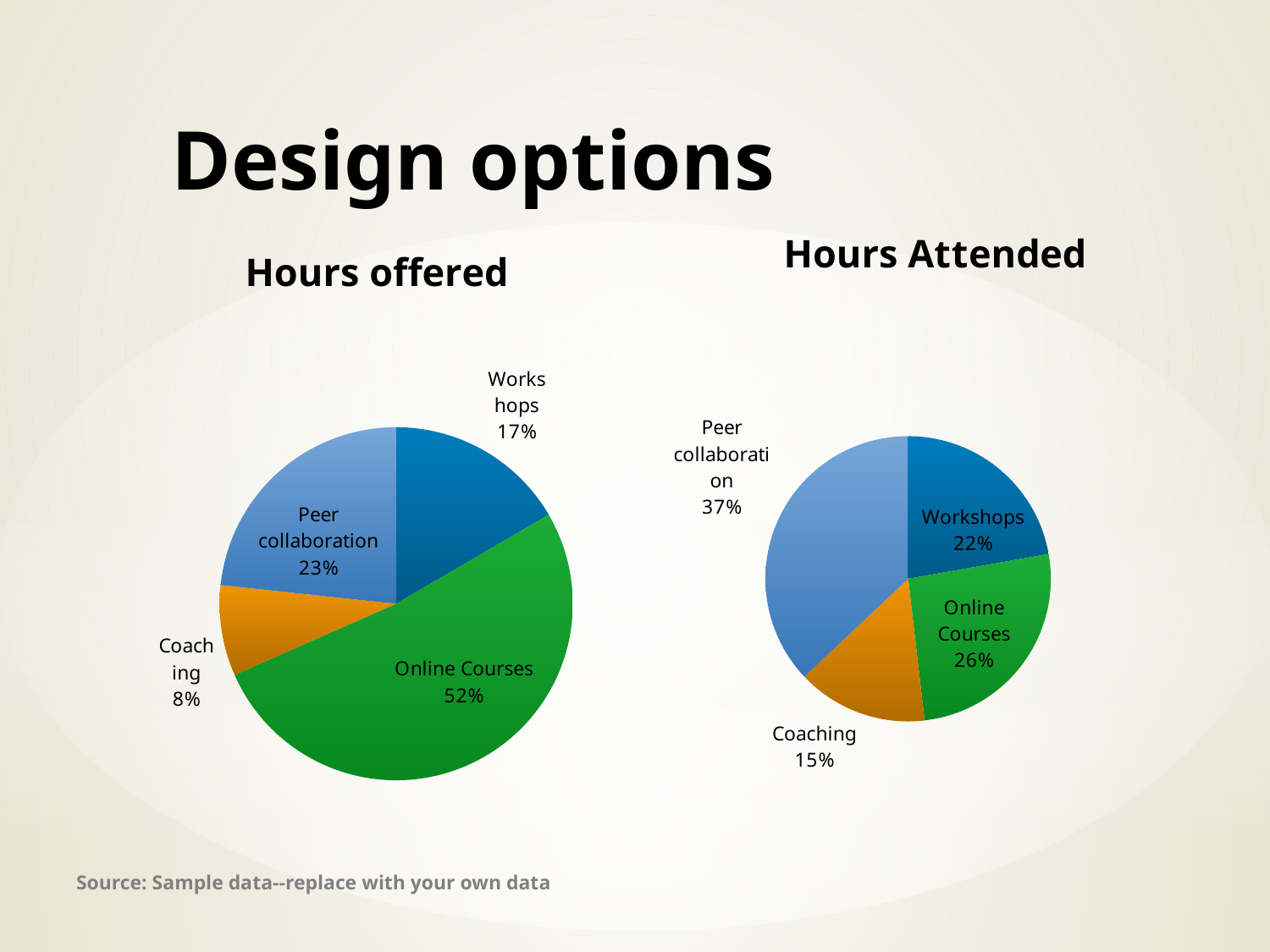
How many categories does the "Hours Attended" chart show? 4 In the "Hours Attended" chart, what share does Workshops have? 22% In the "Hours offered" chart, what is the difference between the Online Courses share and the Peer collaboration share? 29% In the "Hours Attended" chart, which category has the smallest slice? Coaching Which is larger: the Coaching share in the "Hours offered" chart or the Coaching share in the "Hours Attended" chart? Hours Attended In the "Hours offered" chart, what share does Online Courses have? 52% In the "Hours Attended" chart, what share does Peer collaboration have? 37% In the "Hours offered" chart, which category has the largest slice? Online Courses What colour is the Coaching slice in the "Hours offered" chart? Orange What kind of chart is the "Hours offered" chart? Pie chart In the "Hours offered" chart, which category has the smallest slice? Coaching In the "Hours Attended" chart, what is the difference between the Peer collaboration share and the Workshops share? 15%